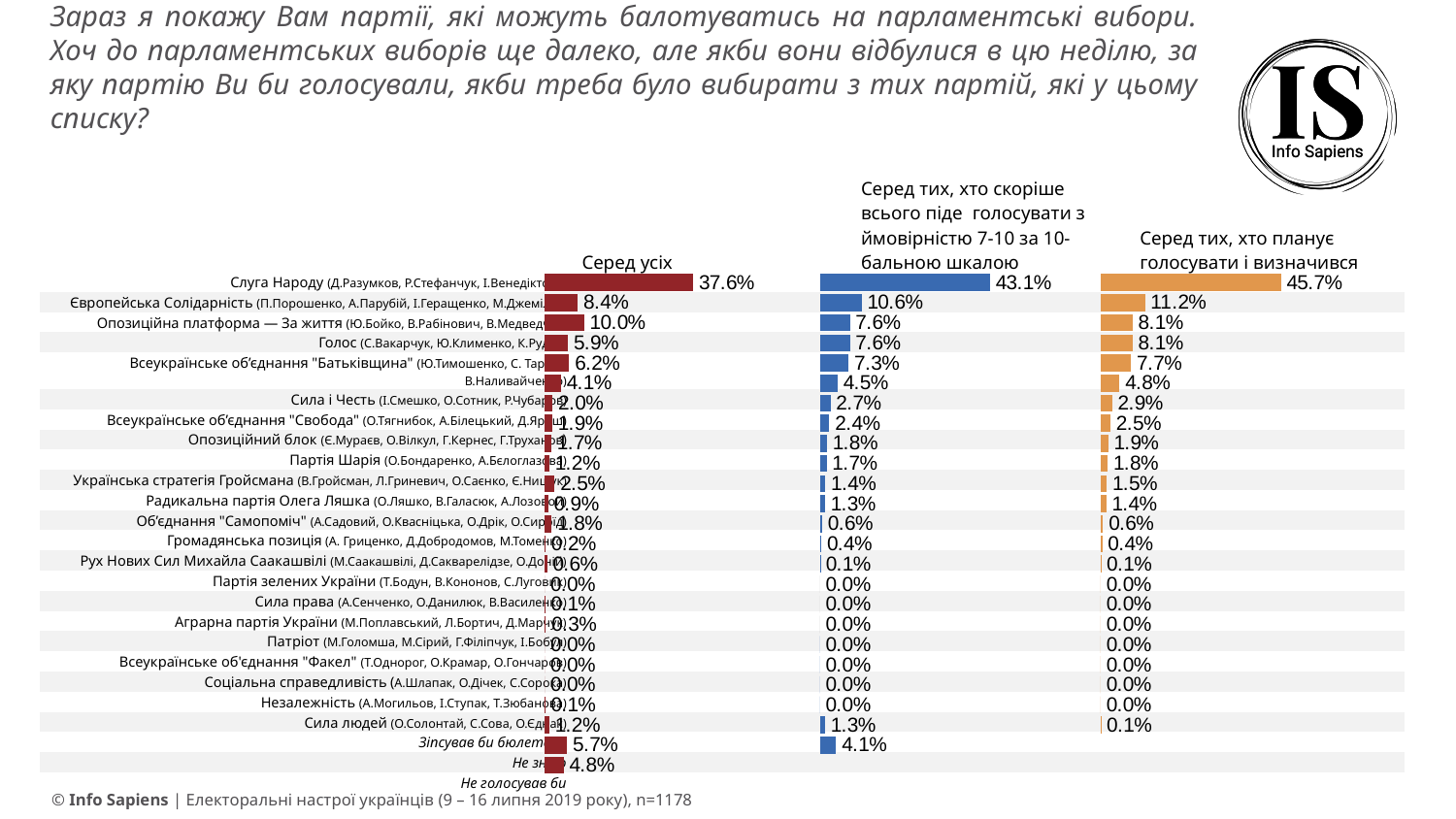
In the 'Серед тих, хто планує голосувати і визначився' chart, what is the difference between Європейська Солідарність and Голос? 3.1% In the 'Серед тих, хто планує голосувати і визначився' chart, what is the value for Слуга Народу? 45.7% In the 'Серед тих, хто скоріше всього піде голосувати з ймовірністю 7-10 за 10-бальною шкалою' chart, what is the difference between Слуга Народу and Європейська Солідарність? 32.5% In the 'Серед усіх' chart, what is the value for Опозиційна платформа — За життя? 10.0% What type of chart is used on this slide? Bar chart In the 'Серед усіх' chart, which is larger: Опозиційна платформа — За життя or Європейська Солідарність? Опозиційна платформа — За життя In the 'Серед усіх' chart, what is the value for Слуга Народу? 37.6% In the 'Серед тих, хто скоріше всього піде голосувати з ймовірністю 7-10 за 10-бальною шкалою' chart, what is the value for Європейська Солідарність? 10.6% In the 'Серед тих, хто планує голосувати і визначився' chart, what is the value for Всеукраїнське об'єднання "Батьківщина"? 7.7% How many charts (respondent groups) are shown side by side on the slide? 3 In the 'Серед усіх' chart, which party has the highest value? Слуга Народу